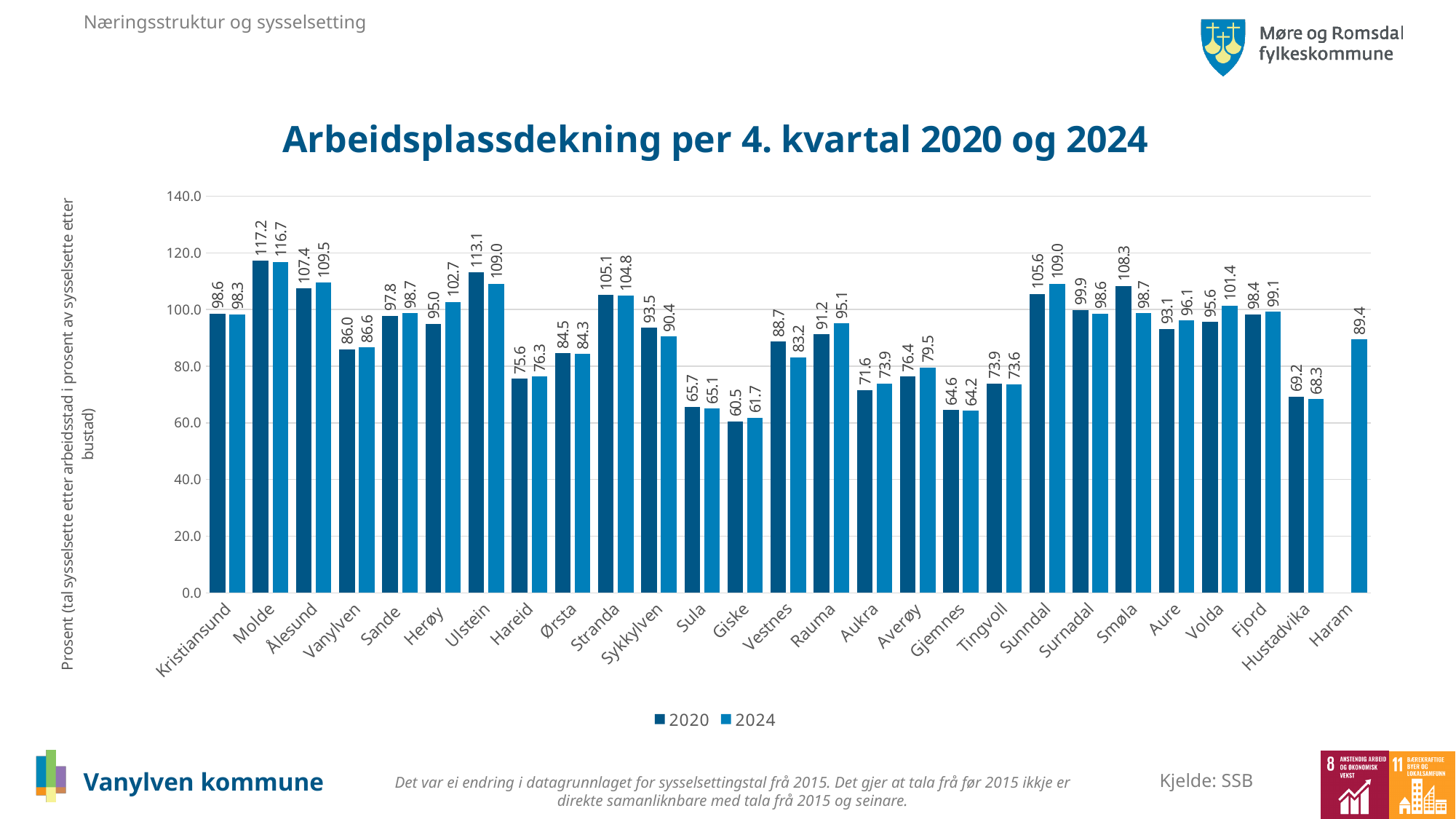
What kind of chart is shown on the slide? Bar chart Which is larger for Sunndal: the 2020 value or the 2024 value? 2024 How many series does the legend list? 2 What is the value for Ulstein in 2020? 113.1 Which municipality has the lowest value in the 2024 series? Giske What is the difference between the 2024 and 2020 values for Herøy? 7.7 What is the difference between the 2020 and 2024 values for Smøla? 9.6 How many municipalities are shown on the x axis? 27 Is the 2020 value for Stranda greater or less than 100? greater What is the value for Vanylven in 2024? 86.6 Which municipality has the highest value in the 2020 series? Molde What is the value for Haram in 2024? 89.4